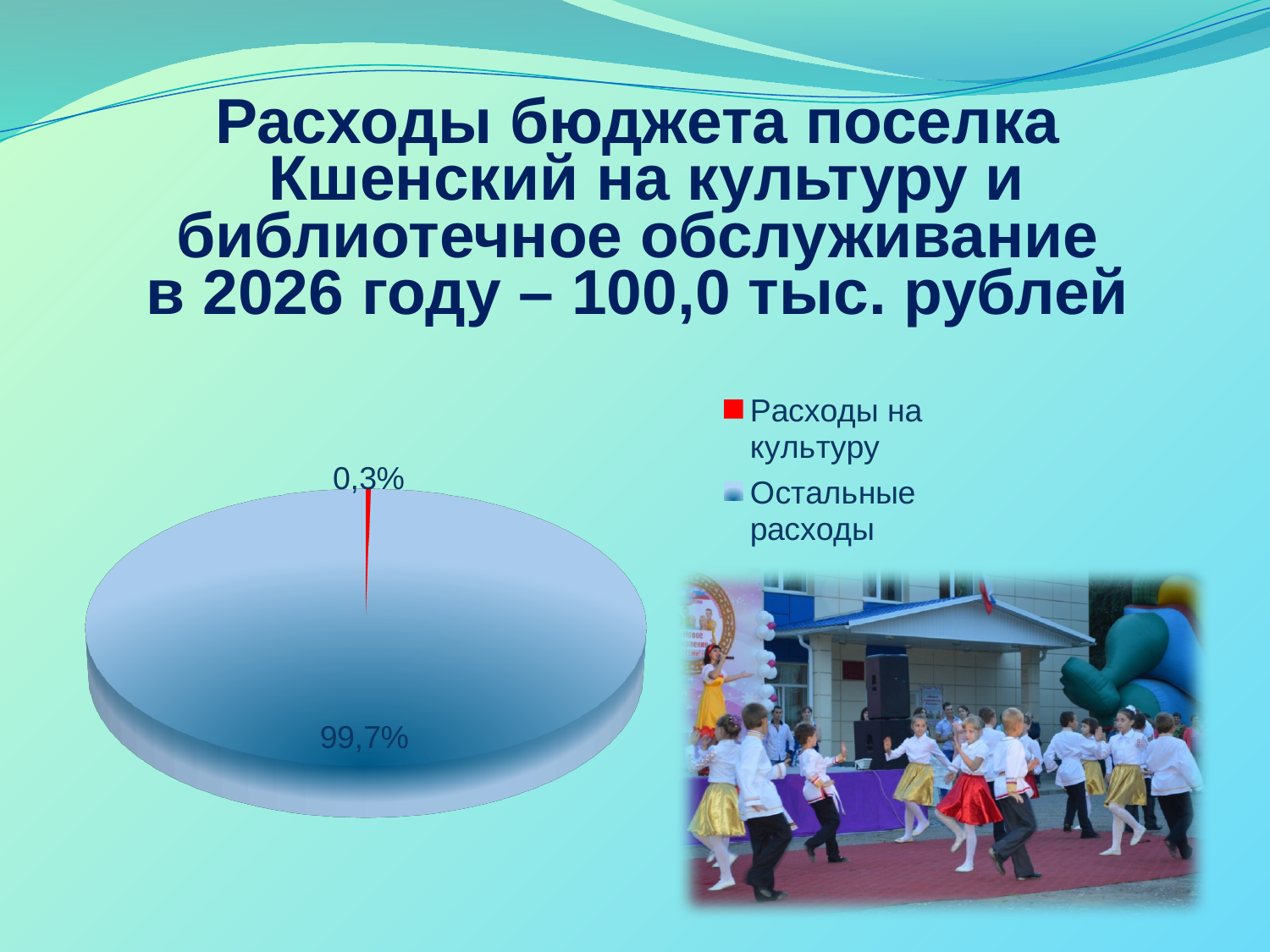
What share of the pie does "Остальные расходы" represent? 99,7% Which is larger: the share for "Расходы на культуру" or the share for "Остальные расходы"? Остальные расходы What share of the pie does "Расходы на культуру" represent? 0,3% What colour is the "Расходы на культуру" slice? red What is the difference in percentage points between the "Остальные расходы" slice and the "Расходы на культуру" slice? 99,4 How many entries does the legend list? 2 Which slice of the pie is the smallest? Расходы на культуру What total amount in thousand rubles does the slide title give for culture and library services spending in 2026? 100,0 тыс. рублей Which slice of the pie is the largest? Остальные расходы What kind of chart is shown on the slide? pie chart How many slices does the pie chart have? 2